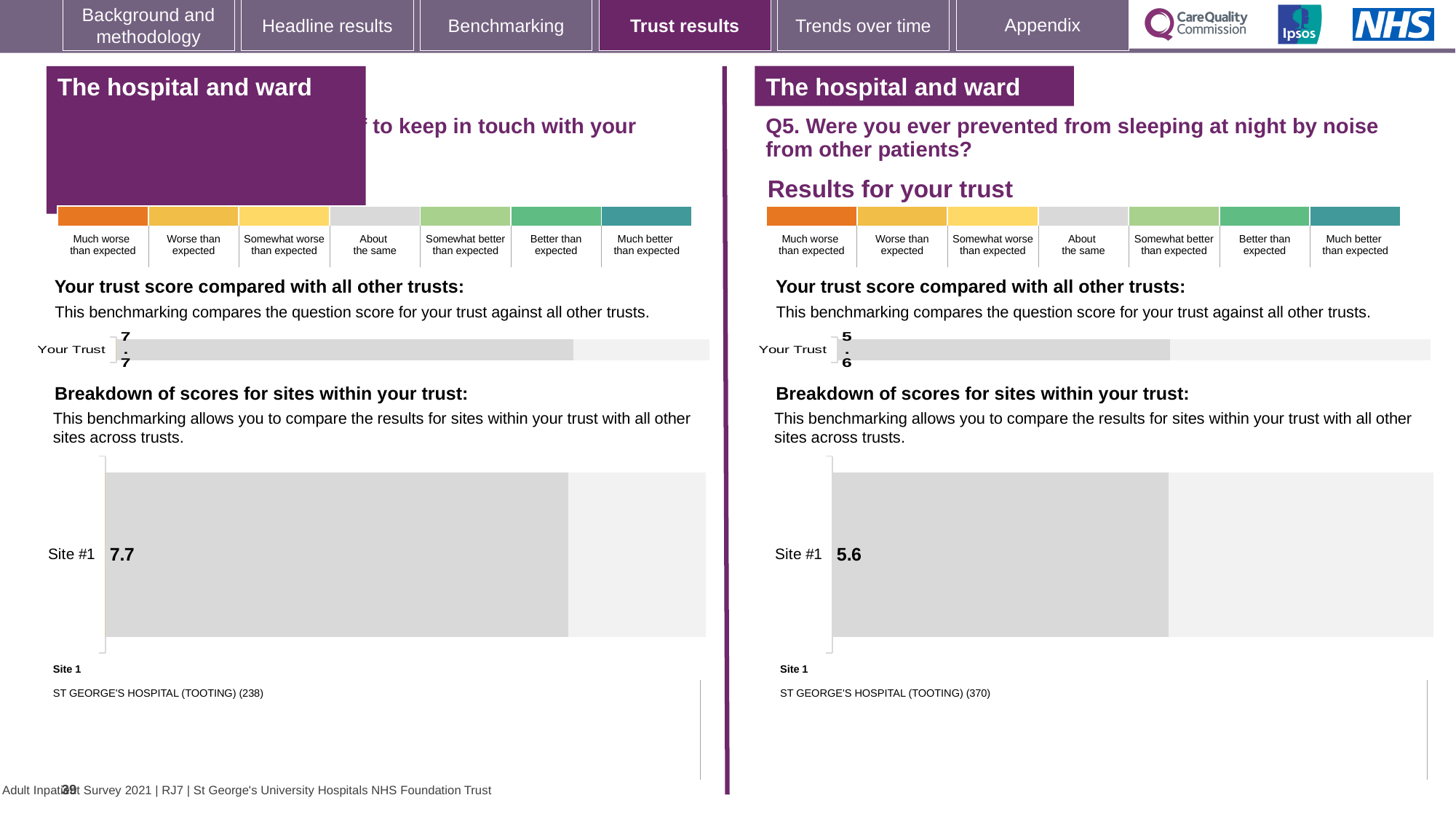
On the left half of the slide, in the 'Your trust score compared with all other trusts' chart, what is the value for Your Trust? 7.7 What type of chart is used to show the Site #1 score in the 'Breakdown of scores for sites within your trust' section on the right half of the slide? Bar chart On the left half of the slide, in the 'Breakdown of scores for sites within your trust' chart, what is the value for Site #1? 7.7 How many sites are shown in the 'Breakdown of scores for sites within your trust' chart on the right half of the slide (Q5)? 1 How many sites are shown in the 'Breakdown of scores for sites within your trust' chart on the left half of the slide? 1 On the left half of the slide, which site name is listed under 'Site 1' below the breakdown chart? ST GEORGE'S HOSPITAL (TOOTING) (238) On the right half of the slide, which site name is listed under 'Site 1' below the breakdown chart? ST GEORGE'S HOSPITAL (TOOTING) (370) On the right half of the slide (Q5), in the 'Your trust score compared with all other trusts' chart, what is the value for Your Trust? 5.6 Which is larger: the Site #1 score in the left-hand breakdown chart or the Site #1 score in the right-hand (Q5) breakdown chart? Left-hand chart (7.7) What is the difference between the Your Trust score on the left half of the slide (7.7) and the Your Trust score on the right half (5.6)? 2.1 On the right half of the slide (Q5), in the 'Breakdown of scores for sites within your trust' chart, what is the value for Site #1? 5.6